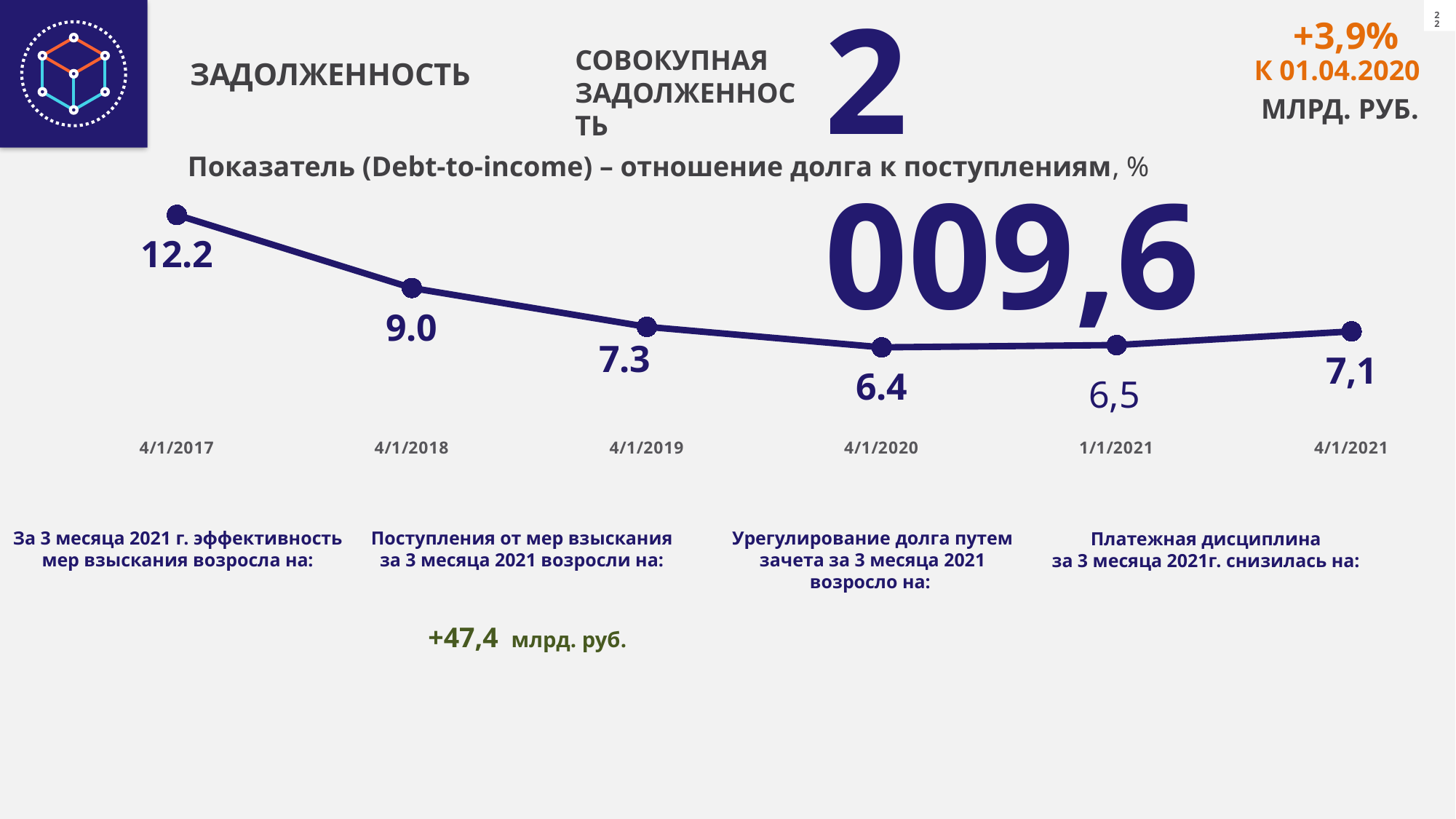
What is the Debt-to-income value for 4/1/2019? 7.3 What is the Debt-to-income value for 4/1/2021? 7,1 Which is larger, the Debt-to-income value for 4/1/2018 or for 4/1/2021? 4/1/2018 Which date has the highest Debt-to-income value? 4/1/2017 Which date has the lowest Debt-to-income value? 4/1/2020 Does the Debt-to-income value rise or fall from 4/1/2017 to 4/1/2020? fall What is the Debt-to-income value for 4/1/2018? 9.0 What is the Debt-to-income value for 4/1/2017? 12.2 How many data points are plotted on the line chart? 6 What is the difference between the Debt-to-income values for 4/1/2017 and 4/1/2018? 3.2 What type of chart is shown on the slide? line chart What is the Debt-to-income value for 1/1/2021? 6,5